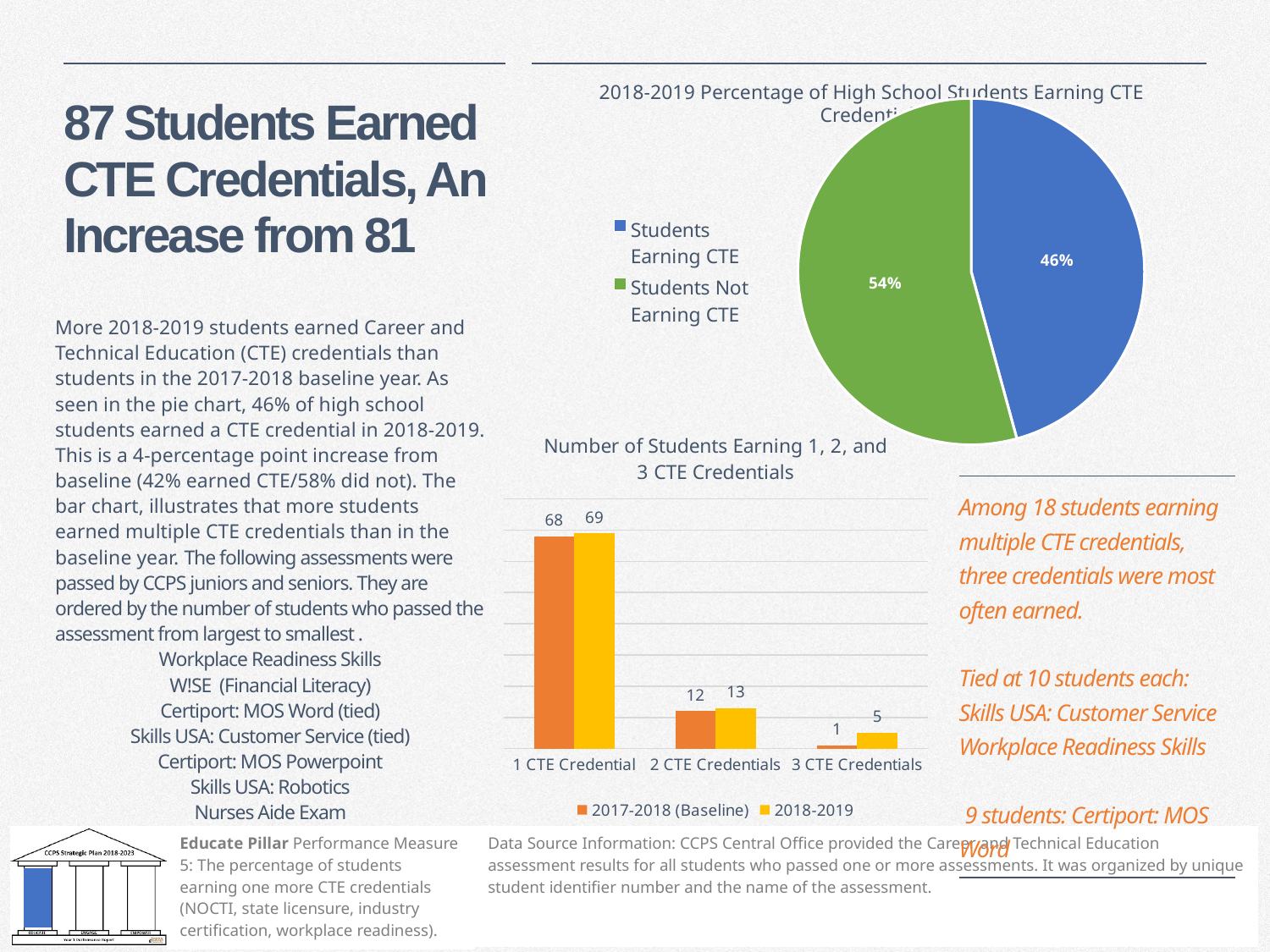
In the bar chart, which category has the lowest 2017-2018 (Baseline) value? 3 CTE Credentials In the pie chart, what share of the pie is Students Not Earning CTE? 54% What type of chart is the chart titled 'Number of Students Earning 1, 2, and 3 CTE Credentials'? Bar chart In the bar chart, what is the 2018-2019 value for 1 CTE Credential? 69 In the bar chart, what is the difference between the 2018-2019 and 2017-2018 (Baseline) values for 3 CTE Credentials? 4 In the bar chart, what is the 2018-2019 value for 3 CTE Credentials? 5 In the pie chart, which slice is larger, Students Earning CTE or Students Not Earning CTE? Students Not Earning CTE In the bar chart, what is the 2017-2018 (Baseline) value for 2 CTE Credentials? 12 In the pie chart, what percentage of high school students earned a CTE credential in 2018-2019? 46% How many slices does the pie chart have? 2 In the bar chart, do the 2018-2019 values rise or fall from 1 CTE Credential to 3 CTE Credentials? Fall How many series does the legend of the bar chart list? 2